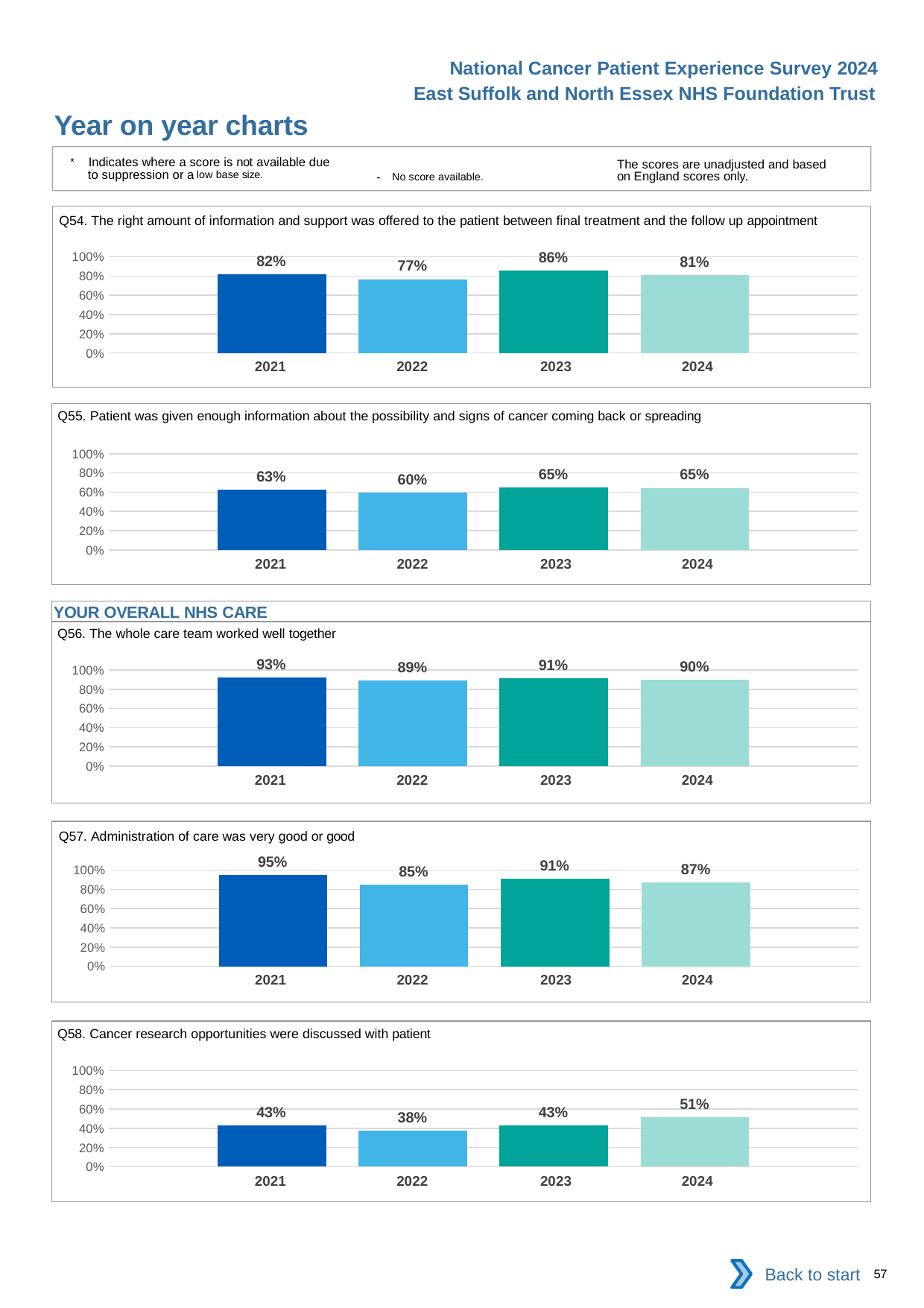
In the Q58 chart, what is the value for 2024? 51% In the Q54 chart, what is the value for 2023? 86% In the Q57 chart, what is the difference between the 2021 and 2022 values? 10 percentage points In the Q54 chart, which year has the lowest value? 2022 What kind of chart is used for Q54? Bar chart In the Q55 chart, what is the value for 2022? 60% How many bars are plotted in the Q58 chart? 4 In the Q57 chart, which is larger, the value for 2022 or the value for 2024? 2024 In the Q56 chart, which year has the highest value? 2021 In the Q55 chart, what is the difference between the 2023 and 2022 values? 5 percentage points In the Q56 chart, what is the value for 2024? 90% In the Q58 chart, is the value for 2022 greater or less than 40%? less